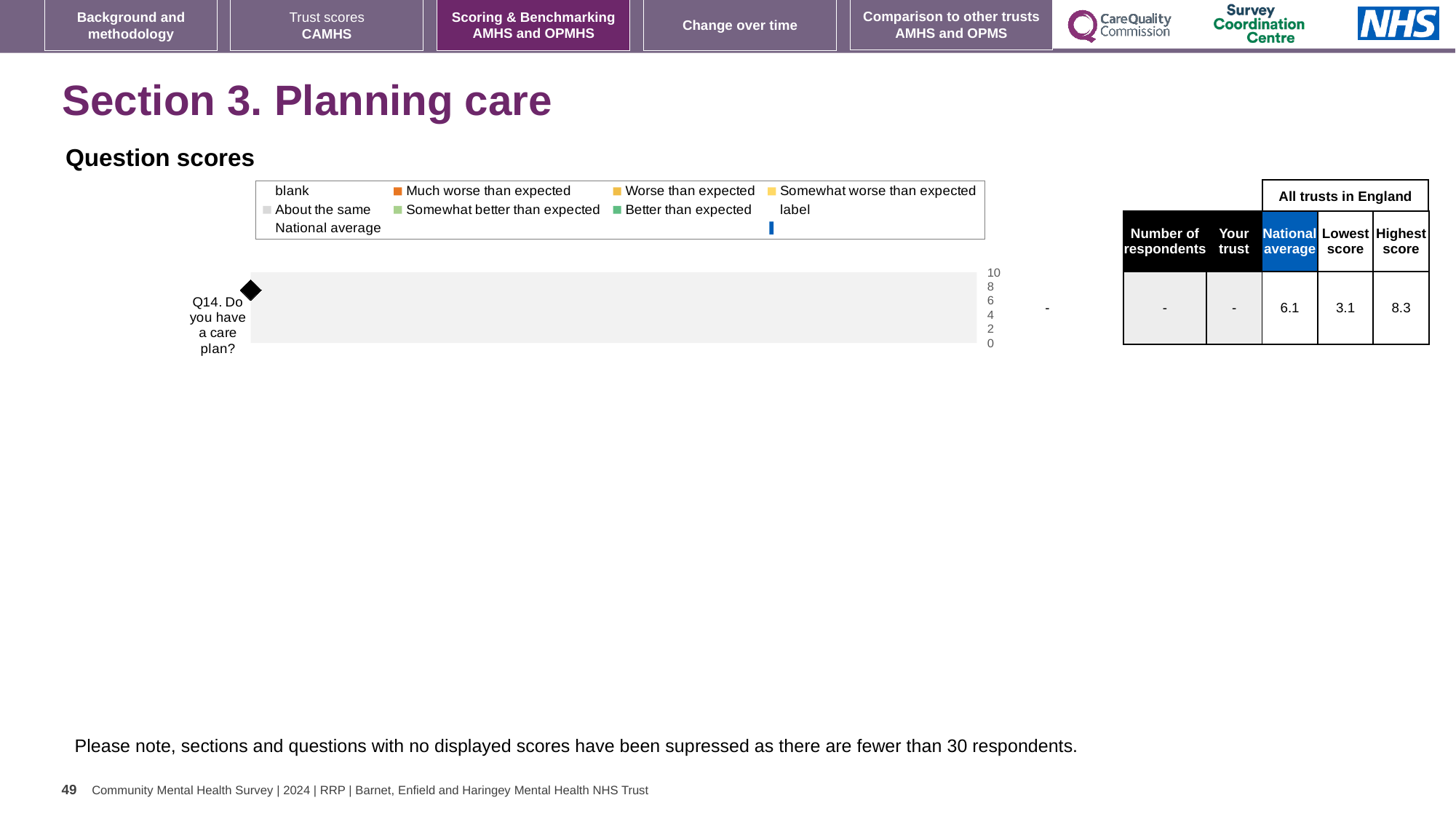
How many questions (categories) are listed on the chart's vertical axis? 1 What colour does the legend use for 'Much worse than expected'? orange What kind of chart is shown under 'Question scores'? bar chart What value label is shown for 'Q14. Do you have a care plan?' on the chart? - What is the highest tick value shown on the chart's numeric axis? 10 In the table beside the chart, what is the Lowest score for Q14? 3.1 In the table beside the chart, what is the Highest score for Q14? 8.3 In the table beside the chart, what is the difference between the Highest score and the Lowest score for Q14? 5.2 In the table beside the chart, what is the National average score for Q14? 6.1